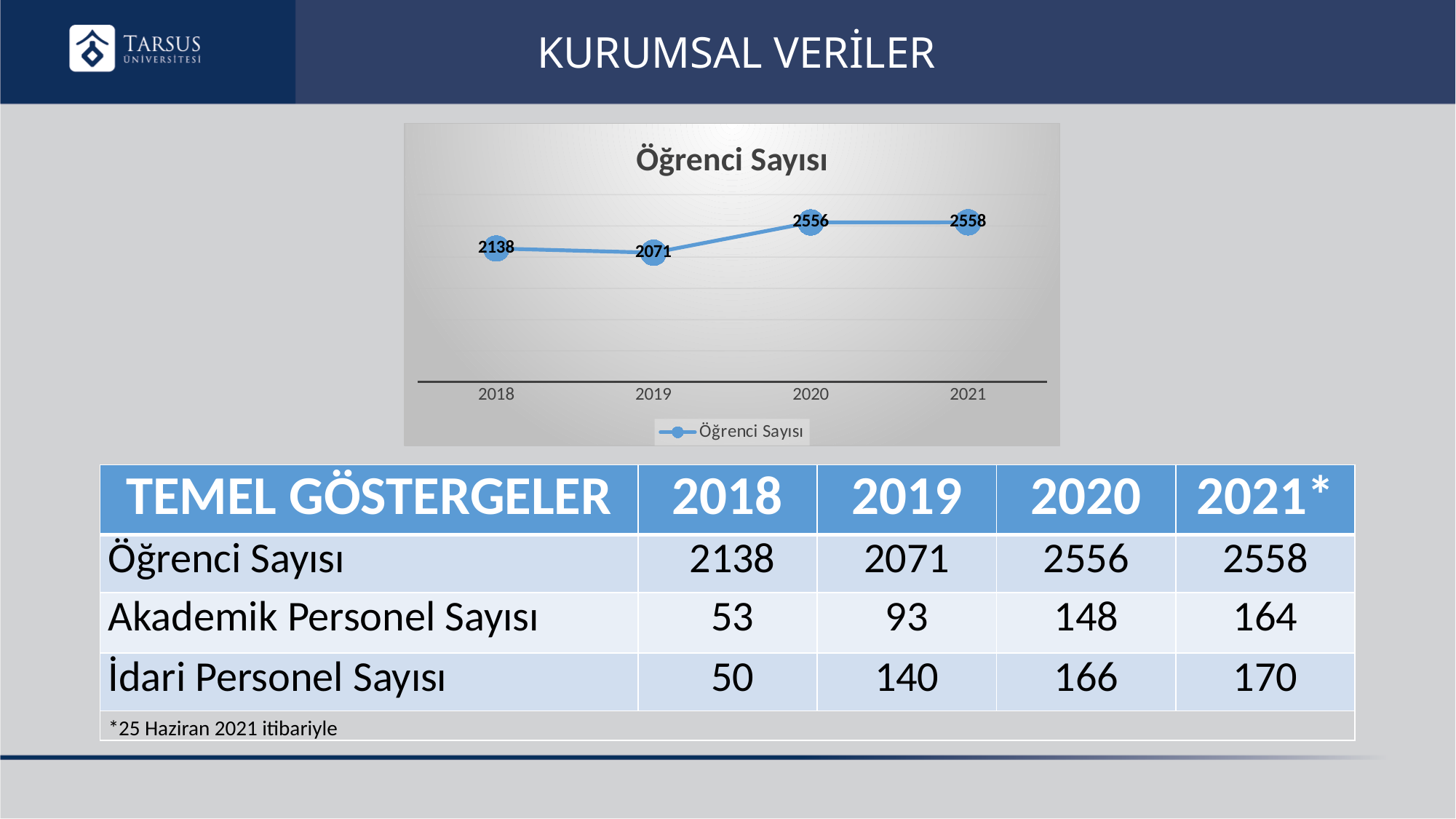
What is the title of the chart on the slide? Öğrenci Sayısı In the Öğrenci Sayısı chart, which is larger, the value for 2018 or the value for 2019? 2018 What is the value for 2018 in the Öğrenci Sayısı chart? 2138 How many series does the legend of the Öğrenci Sayısı chart list? 1 What is the value for 2020 in the Öğrenci Sayısı chart? 2556 What is the difference between the 2020 and 2019 values in the Öğrenci Sayısı chart? 485 What is the value for 2021 in the Öğrenci Sayısı chart? 2558 What kind of chart is the Öğrenci Sayısı chart? line chart What is the difference between the 2018 and 2019 values in the Öğrenci Sayısı chart? 67 Which year has the lowest value in the Öğrenci Sayısı chart? 2019 What is the value for 2019 in the Öğrenci Sayısı chart? 2071 How many data points are plotted in the Öğrenci Sayısı chart? 4